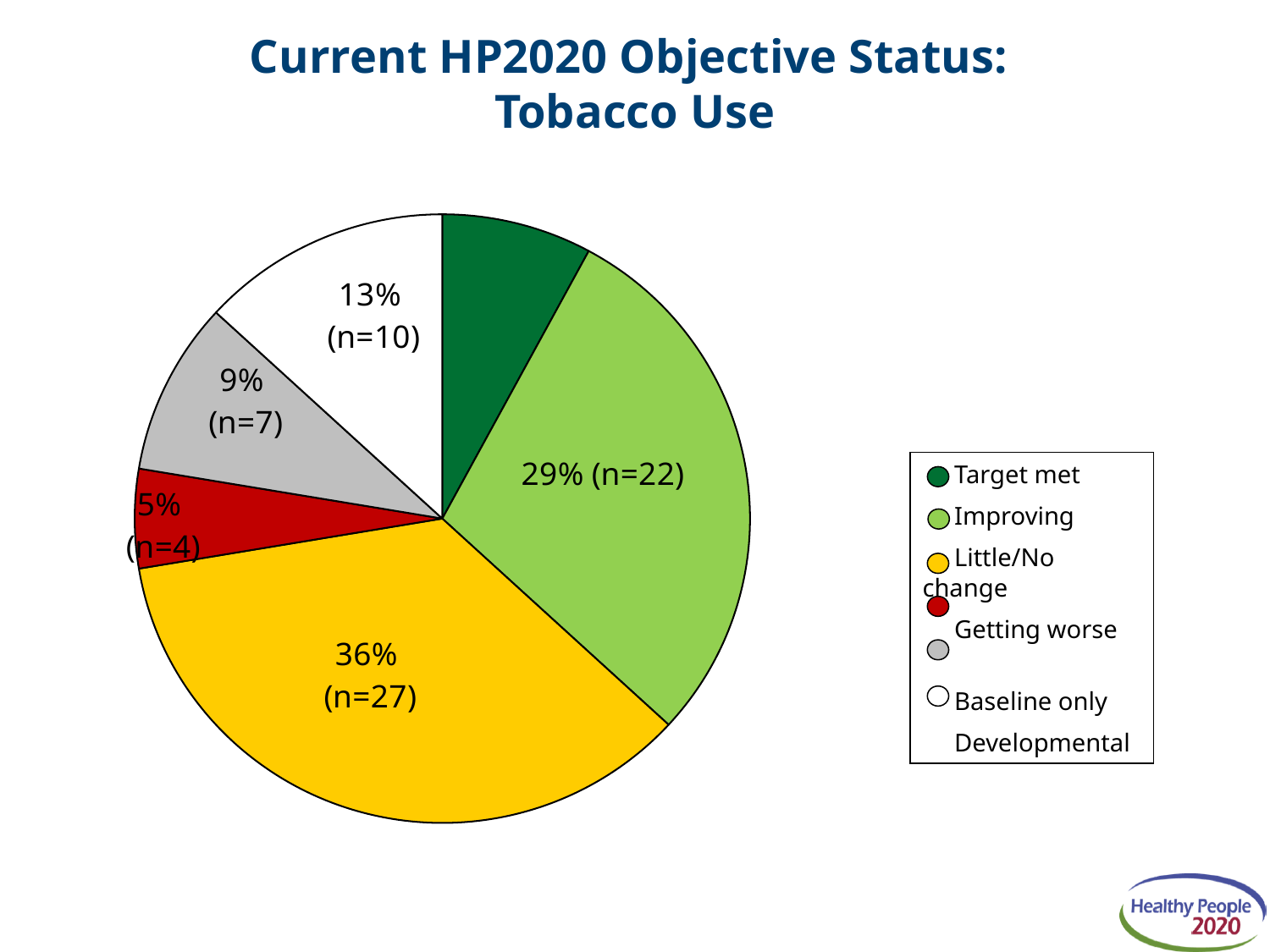
What colour is the Little/No change slice? yellow What percentage of objectives are Developmental? 13% What percentage of objectives are in the Little/No change category? 36% Which category has the largest share of the pie? Little/No change What percentage of objectives are Baseline only? 9% How many categories does the legend list? 6 What kind of chart is shown on the slide? pie chart How many more objectives are in Little/No change than in Improving? 5 How many objectives (n) are in the Improving category? n=22 How many objectives (n) are in the Getting worse category? n=4 Which slice is larger, Baseline only or Developmental? Developmental What is the difference in percentage points between the Little/No change and Improving slices? 7